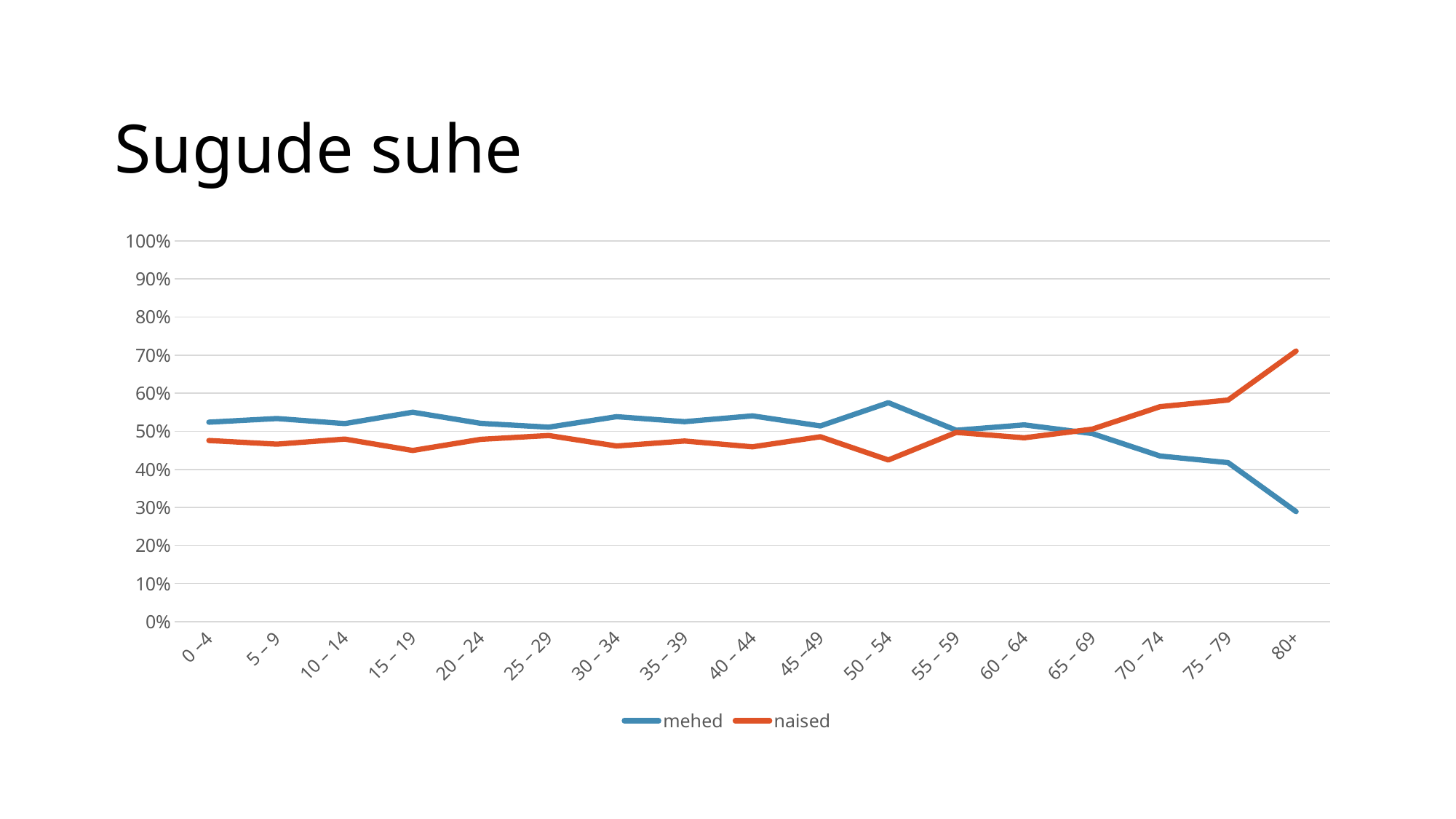
How many age groups are shown on the x axis? 17 Which age group has the highest value for mehed? 50–54 Does the mehed line rise or fall from the 65–69 group to the 80+ group? fall Which age group has the highest value for naised? 80+ Is the value for naised in the 80+ group greater or less than 60%? greater Which age group has the lowest value for naised? 50–54 Is the value for mehed in the 80+ group greater or less than 40%? less What kind of chart is shown on the slide? line chart How many series does the legend list? 2 Which age group has the lowest value for mehed? 80+ In the 80+ group, which series has the larger value, mehed or naised? naised Is the value for naised in the 15–19 group greater or less than 50%? less